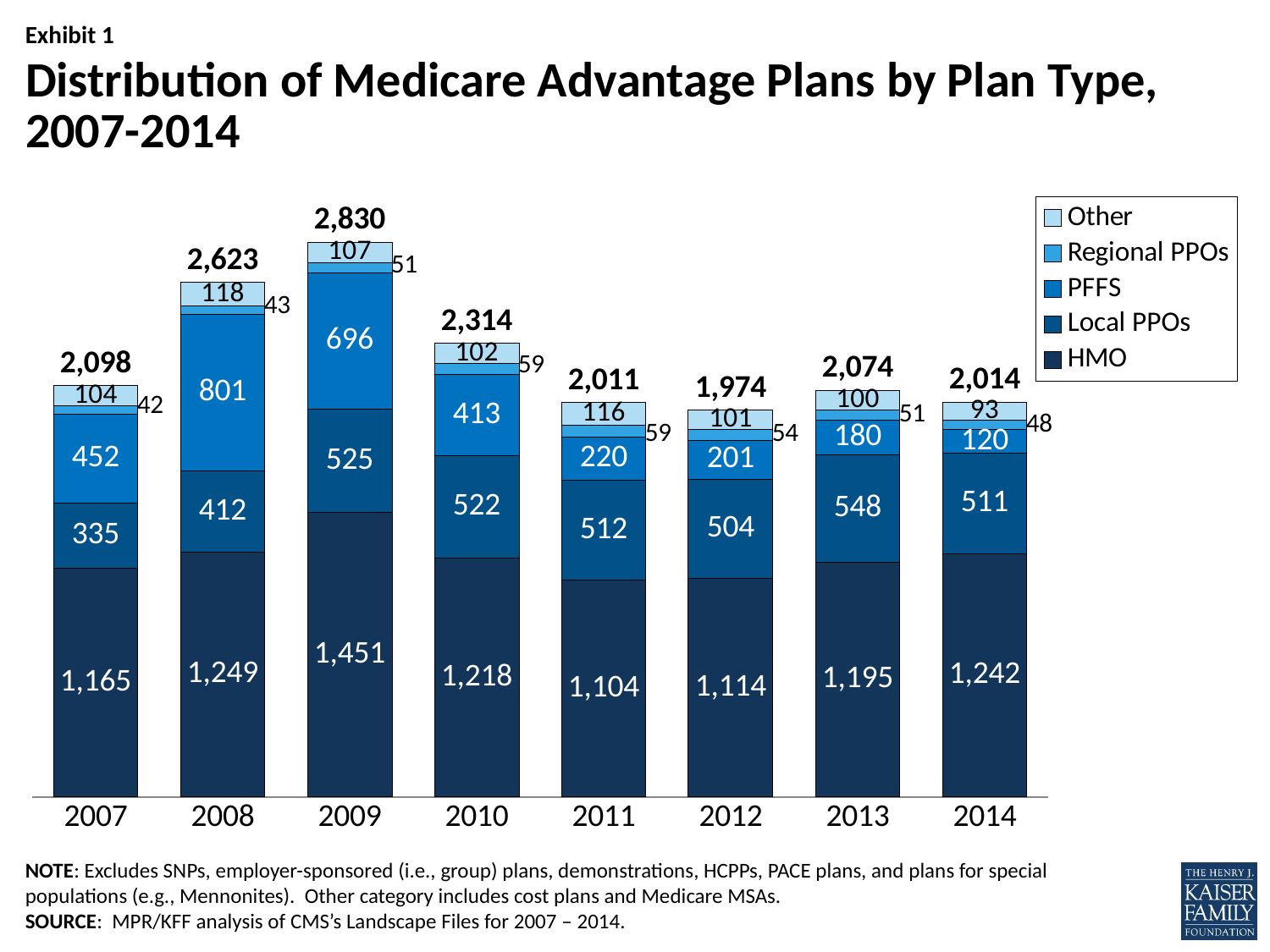
Which year has the highest total number of Medicare Advantage plans? 2009 What is the total number of plans in 2014? 2,014 Which is larger, the number of HMO plans in 2011 or in 2012? 2012 What type of chart is shown on the slide? Stacked bar chart How many series does the legend list? 5 Which year has the lowest total number of Medicare Advantage plans? 2012 How many years are shown on the x axis? 8 Do the number of PFFS plans rise or fall from 2008 to 2014? Fall What is the difference between the number of PFFS plans in 2008 and in 2014? 681 What is the number of HMO plans in 2009? 1,451 What is the number of PFFS plans in 2008? 801 What is the number of Local PPOs in 2013? 548